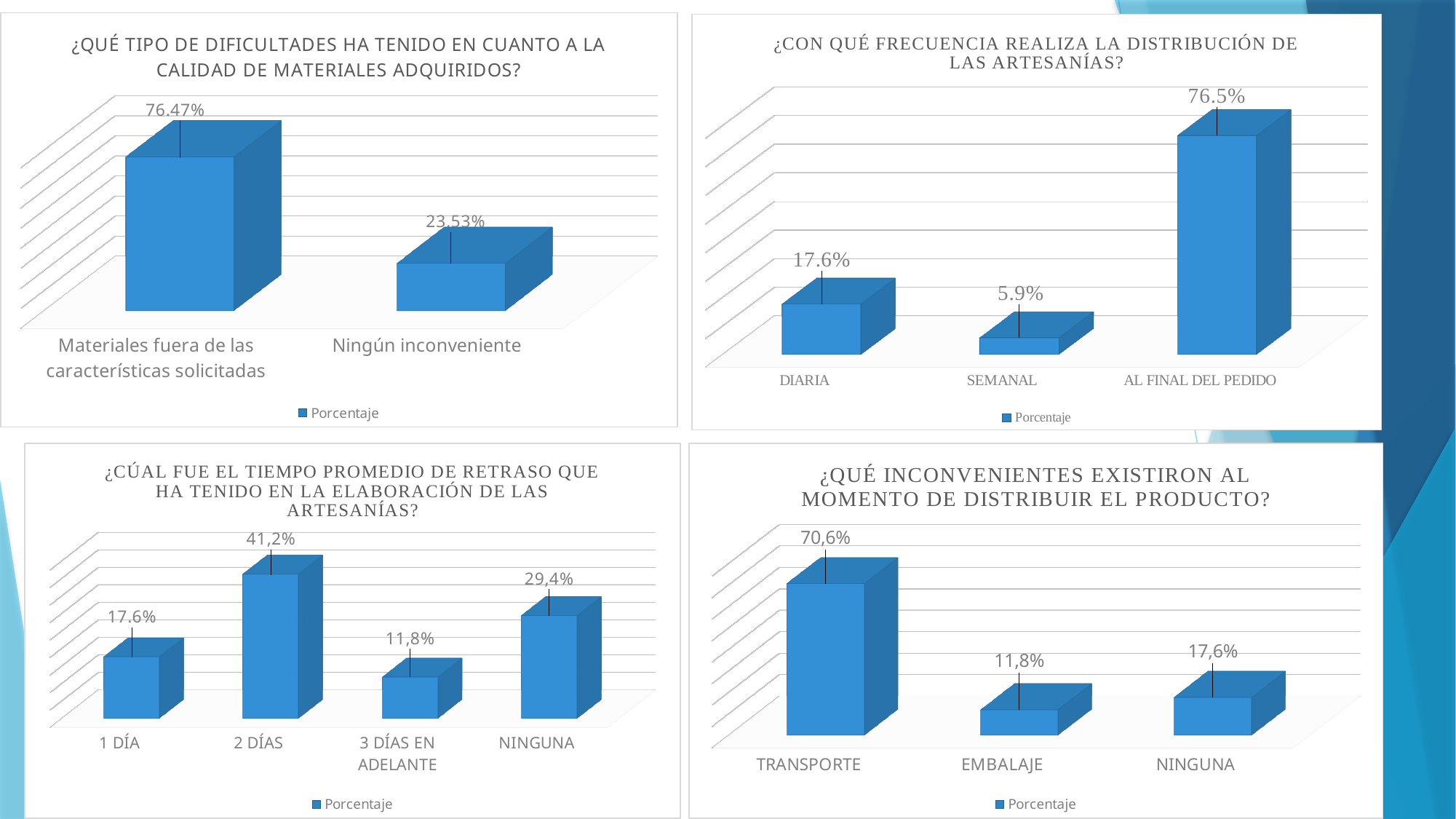
In the bottom-right chart about problems when distributing the product, what is the value for TRANSPORTE? 70,6% In the bottom-right chart about problems when distributing the product, which is larger, EMBALAJE or NINGUNA? NINGUNA In the bottom-left chart about the average delay in making the handicrafts, what is the value for '2 DÍAS'? 41,2% In the bottom-left chart about the average delay in making the handicrafts, how many categories are shown? 4 In the bottom-left chart about the average delay in making the handicrafts, which category has the lowest value? 3 DÍAS EN ADELANTE In the top-right chart about how often the handicrafts are distributed, which category has the highest value? AL FINAL DEL PEDIDO In the top-right chart about how often the handicrafts are distributed, what is the difference between AL FINAL DEL PEDIDO and DIARIA? 58.9% In the top-right chart about how often the handicrafts are distributed, what is the value for SEMANAL? 5.9% In the top-left chart about difficulties with the quality of acquired materials, what is the value for 'Ningún inconveniente'? 23.53% In the bottom-right chart about problems when distributing the product, what is the difference between TRANSPORTE and EMBALAJE? 58,8% In the top-left chart about difficulties with the quality of acquired materials, what is the value for 'Materiales fuera de las características solicitadas'? 76.47% What type of chart is the top-right chart about how often the handicrafts are distributed? Bar chart